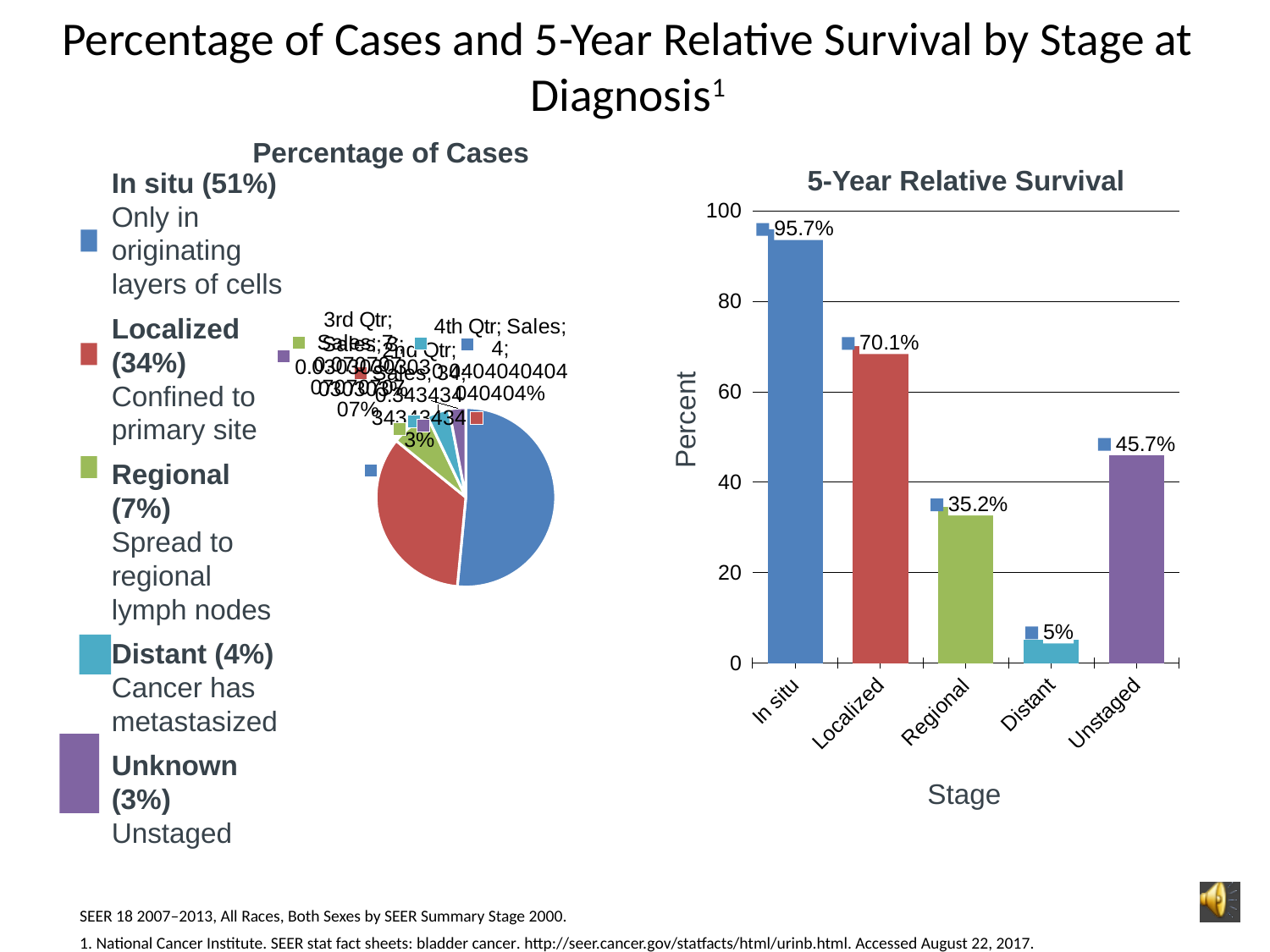
In the 5-Year Relative Survival chart, which stage has the lowest survival? Distant What kind of chart is the 5-Year Relative Survival chart? bar chart In the 5-Year Relative Survival chart, what is the difference between the In situ and Localized values? 25.6% In the 5-Year Relative Survival chart, is the value for Distant greater or less than 20? less In the 5-Year Relative Survival chart, which stage has the highest survival? In situ In the 5-Year Relative Survival chart, what is the value for Unstaged? 45.7% In the 5-Year Relative Survival chart, what is the value for Regional? 35.2% In the 5-Year Relative Survival chart, what is the value for In situ? 95.7% What kind of chart is the Percentage of Cases chart on the left? pie chart How many stages are shown on the x axis of the 5-Year Relative Survival chart? 5 In the 5-Year Relative Survival chart, which is larger, the value for Regional or the value for Unstaged? Unstaged In the 5-Year Relative Survival chart, what is the value for Localized? 70.1%